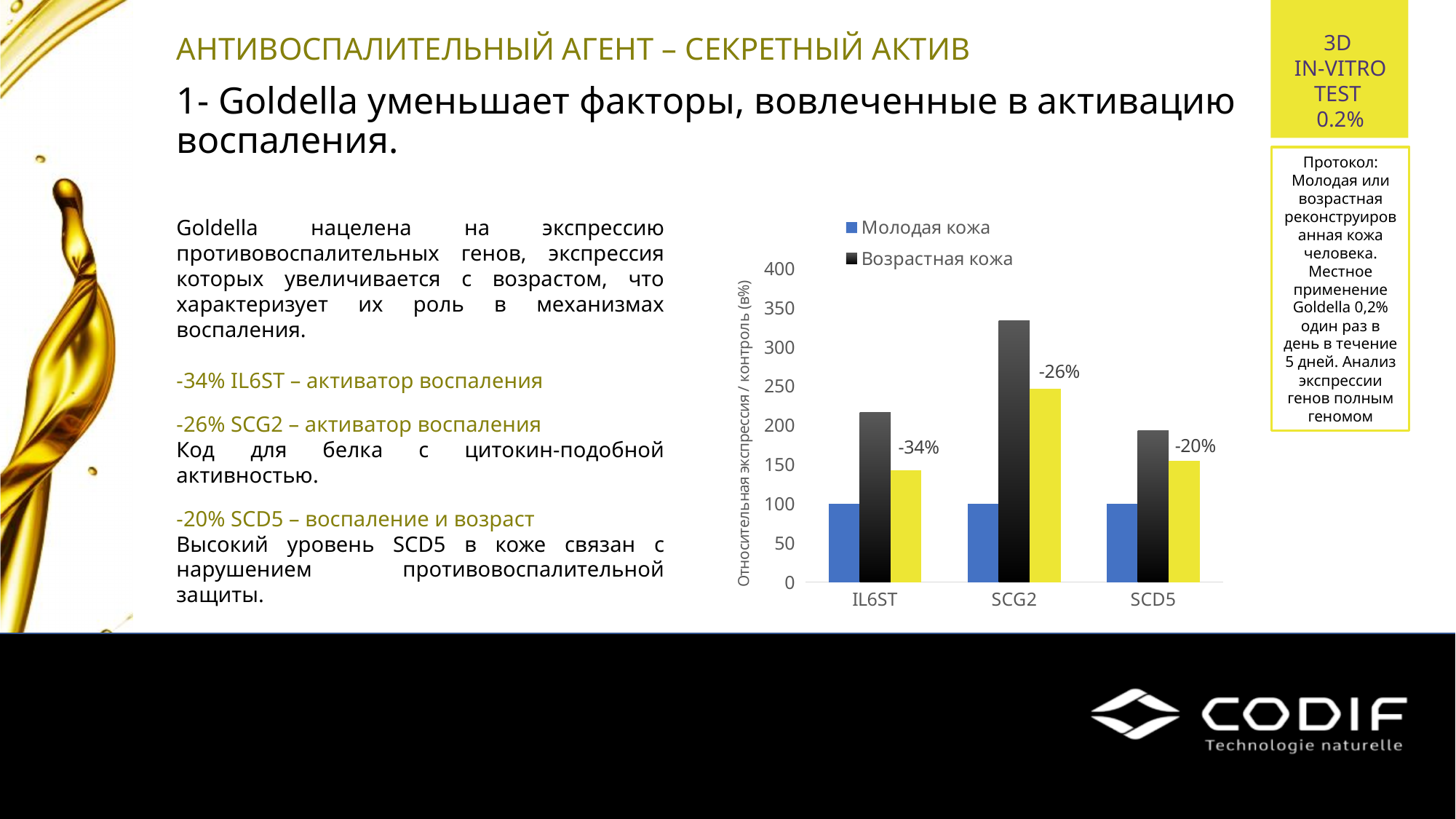
What is the title of the vertical axis of the chart? Относительная экспрессия / контроль (в%) What percentage label is shown next to the yellow bar for SCG2? -26% Is the value of Возрастная кожа for IL6ST greater or less than 200? greater For SCG2, which is larger: Молодая кожа or Возрастная кожа? Возрастная кожа Is the value of Возрастная кожа for SCG2 greater or less than 300? greater Which category has the highest value for Возрастная кожа? SCG2 How many series does the chart legend list? 2 What percentage label is shown next to the yellow bar for IL6ST? -34% How many categories are shown on the x axis of the chart? 3 What is the value of Молодая кожа for IL6ST? 100 What percentage label is shown next to the yellow bar for SCD5? -20% What kind of chart is shown on the slide? bar chart